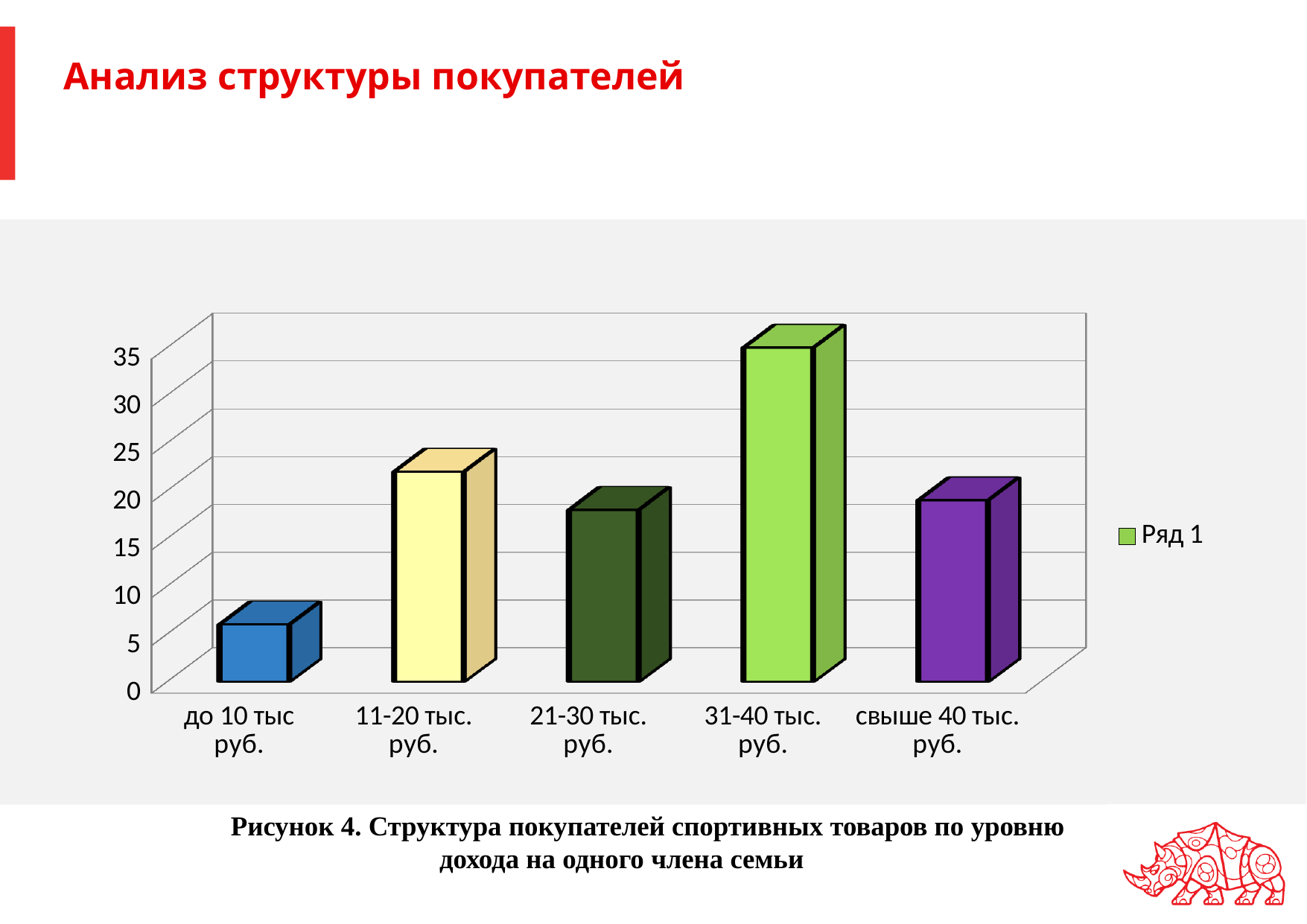
How many income categories are shown on the x axis of the chart? 5 What kind of chart is shown on the slide? bar chart Which income category has the lowest bar? до 10 тыс руб. Is the value for 31-40 тыс. руб. greater or less than 30? greater Which income category has the highest bar? 31-40 тыс. руб. Which is larger, the value for 11-20 тыс. руб. or the value for 21-30 тыс. руб.? 11-20 тыс. руб. Is the value for 21-30 тыс. руб. greater or less than 20? less Is the value for до 10 тыс руб. greater or less than 10? less How many series does the chart legend list? 1 What is the name of the series in the chart legend? Ряд 1